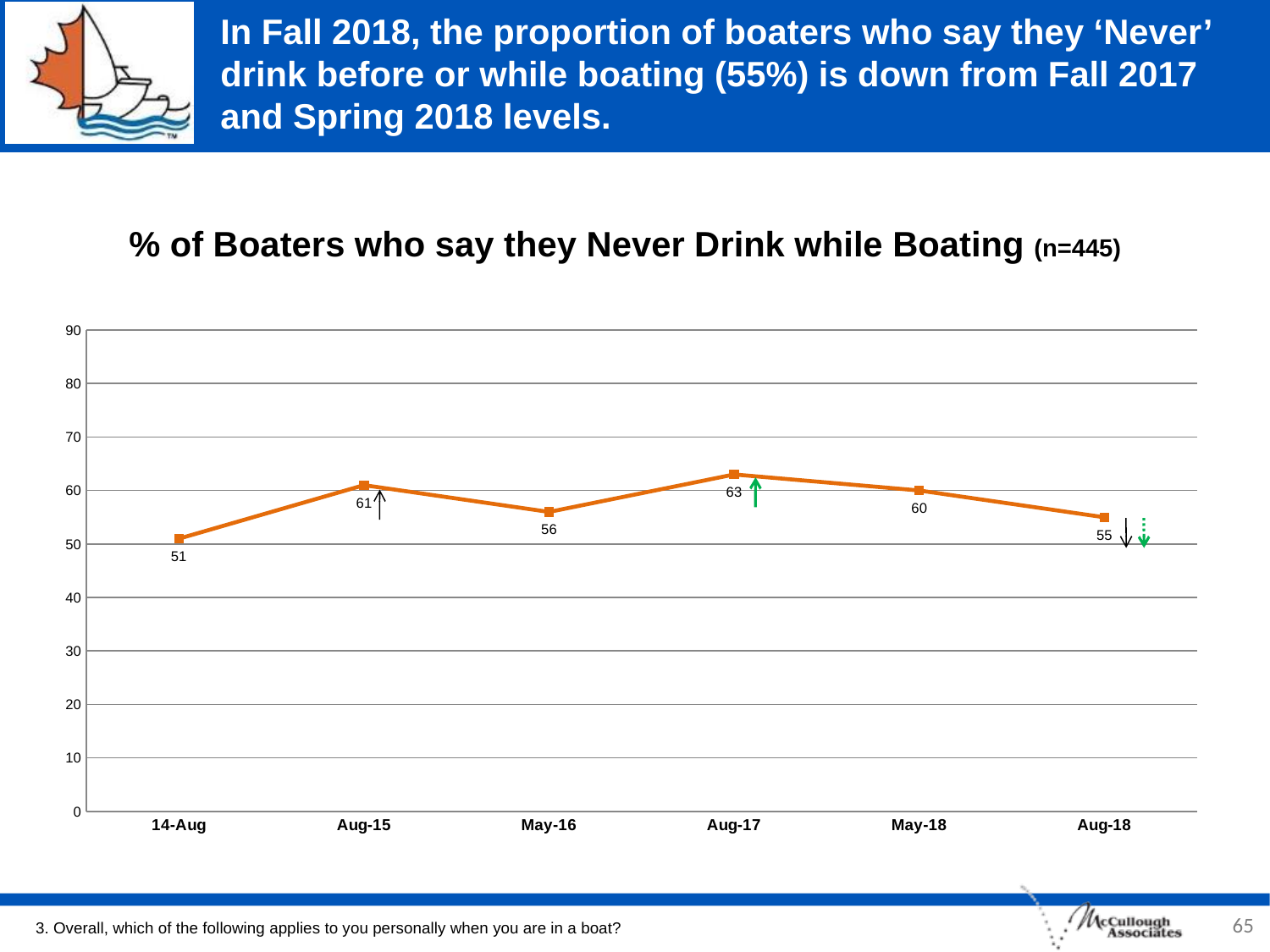
Which period has the highest value? Aug-17 What is the difference between the Aug-17 value and the Aug-18 value? 8 What is the value for 14-Aug? 51 What sample size (n) is shown in the chart title? n=445 Which is larger, the value for Aug-15 or the value for May-16? Aug-15 What is the value for Aug-17? 63 What is the value for May-18? 60 Does the value rise or fall from May-18 to Aug-18? fall How many time periods are plotted on the x axis? 6 What kind of chart is shown? line chart Which period has the lowest value? 14-Aug Is the value for Aug-18 greater or less than 60? less